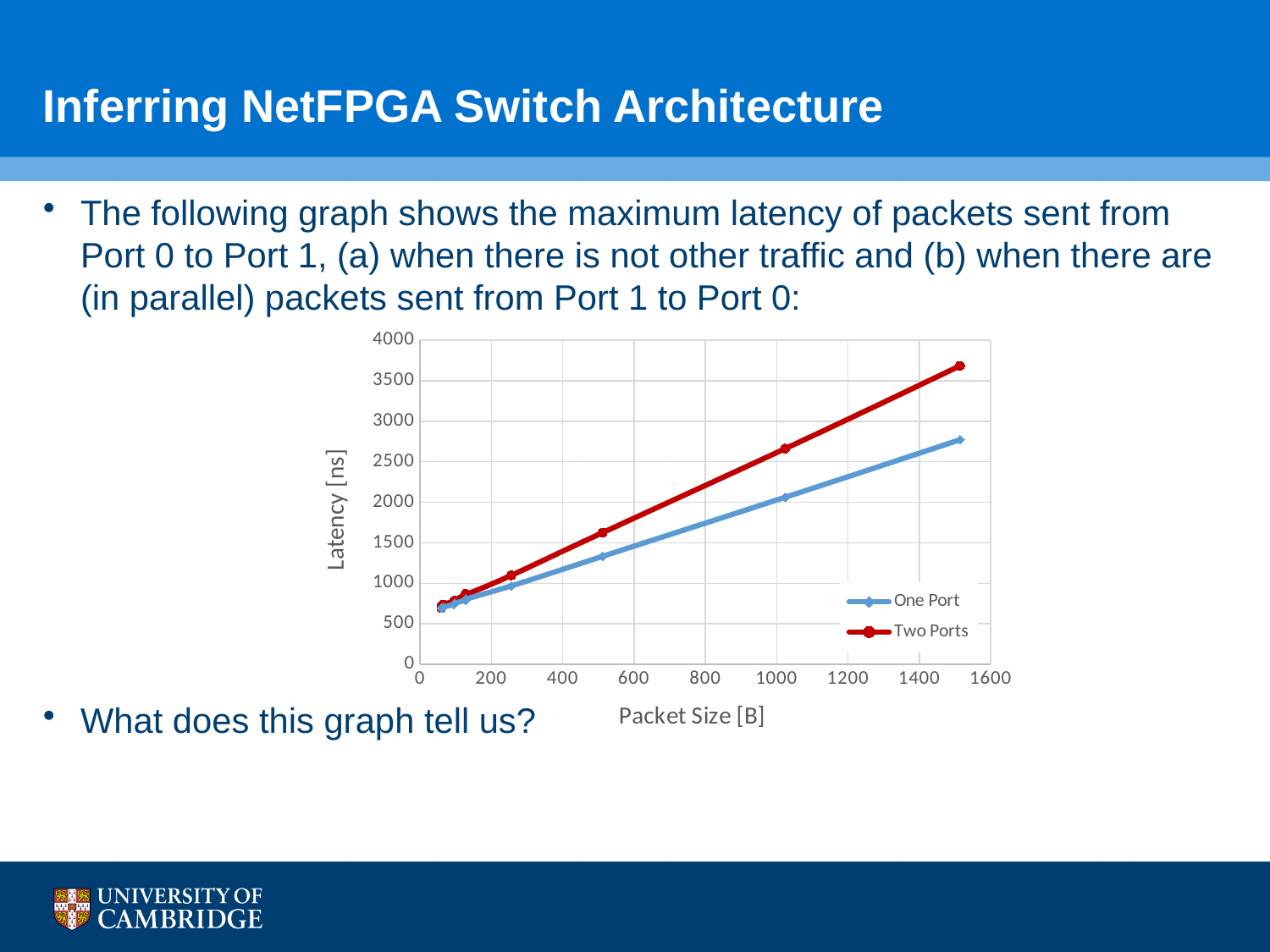
Is the latency for the Two Ports series at a packet size of about 500 B greater or less than 1500? greater What are the two series named in the chart's legend? One Port and Two Ports Does the latency for the One Port series rise or fall as packet size increases? rise Is the latency for the Two Ports series at the largest packet size plotted greater or less than 3500? greater At the largest packet size plotted, which series has the higher latency, One Port or Two Ports? Two Ports Does the latency for the Two Ports series rise or fall as packet size increases? rise What kind of chart is shown on the slide? line chart Is the latency for the One Port series at the largest packet size plotted greater or less than 3000? less What is the label of the chart's y axis? Latency [ns] How many series does the chart's legend list? 2